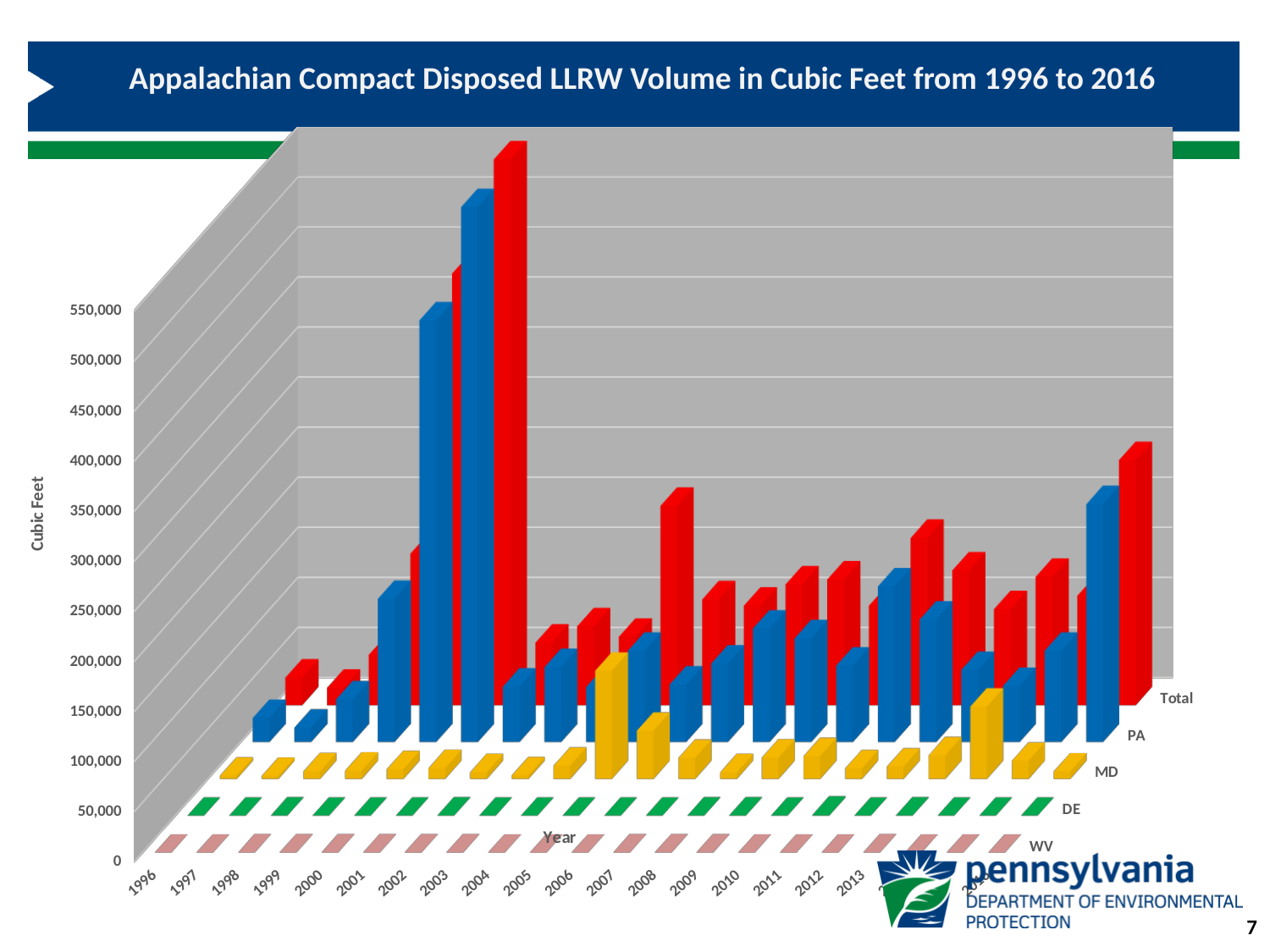
Does the Total disposed volume rise steadily from 1996 to 2016? No Is the Total value for 2003 greater or less than 400,000? less Is the Total value for 1996 greater or less than 300,000? less Which is larger, the Total value for 2003 or the Total value for 2008? 2008 In which year is the Total disposed volume highest? 2001 How many series does the chart plot? 5 In which year is the PA disposed volume highest? 2001 How many years are plotted along the x axis? 21 Which is larger, the PA value for 2003 or the PA value for 1996? 2003 What is the title of the chart? Appalachian Compact Disposed LLRW Volume in Cubic Feet from 1996 to 2016 What kind of chart is shown on the slide? bar chart Which series are plotted in the chart? WV, DE, MD, PA, Total